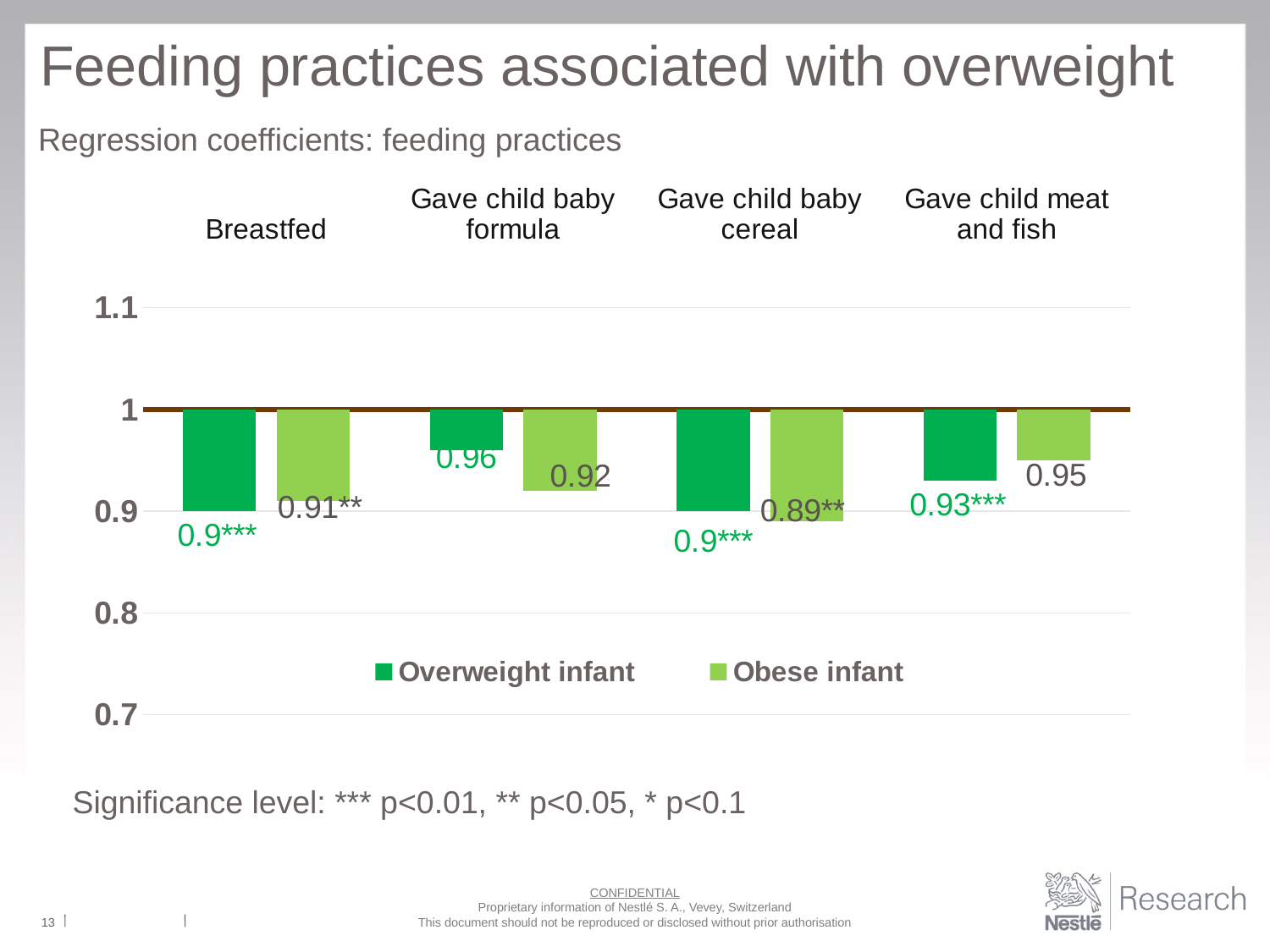
Which feeding practice has the highest Overweight infant coefficient? Gave child baby formula What kind of chart is shown on the slide? bar chart What is the Obese infant value for Gave child meat and fish? 0.95 What is the data label shown for Obese infant in the Breastfed category? 0.91** What is the data label shown for Overweight infant in the Gave child meat and fish category? 0.93*** What is the difference between the Overweight infant and Obese infant values for Gave child baby formula? 0.04 Which feeding practice has the lowest Obese infant coefficient? Gave child baby cereal How many series does the legend list? 2 What is the Overweight infant value for Gave child baby formula? 0.96 How many feeding practice categories are shown on the chart? 4 For Gave child meat and fish, which series has the larger value, Overweight infant or Obese infant? Obese infant Is the Obese infant value for Gave child baby cereal greater or less than 0.9? less